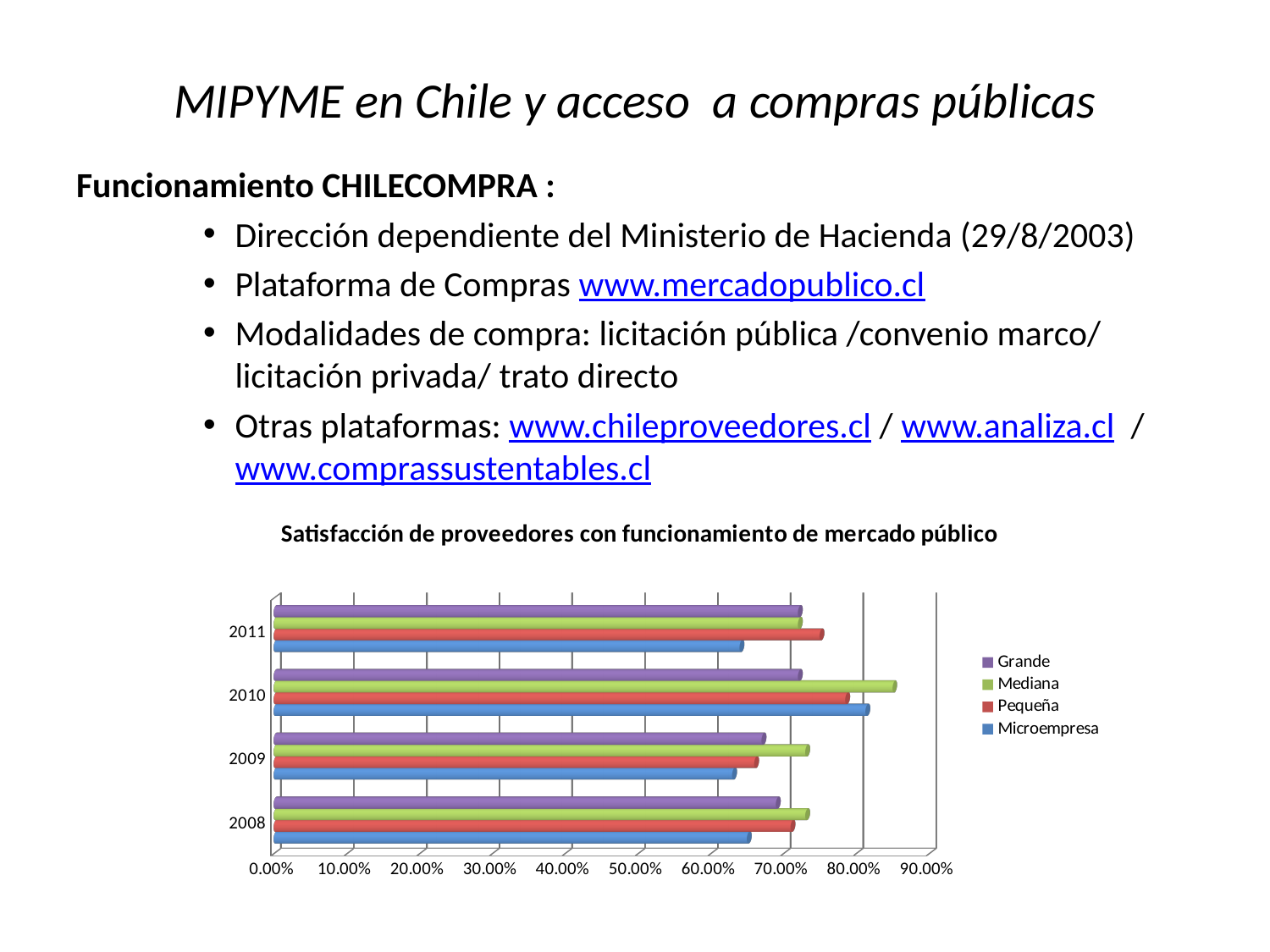
How many years (categories) are shown on the chart's vertical axis? 4 In 2010, which series has the highest satisfaction value? Mediana Which is larger for Microempresa: the value in 2010 or the value in 2011? 2010 What kind of chart is shown on the slide? bar chart How many series does the chart legend list? 4 In 2011, which series has the lowest satisfaction value? Microempresa Is the value for Microempresa in 2011 greater or less than 70.00%? less What is the title of the chart? Satisfacción de proveedores con funcionamiento de mercado público Is the value for Mediana in 2010 greater or less than 80.00%? greater In which year is the Mediana value the highest? 2010 Which is larger in 2010: the value for Mediana or the value for Grande? Mediana Which series is shown in green in the chart legend? Mediana